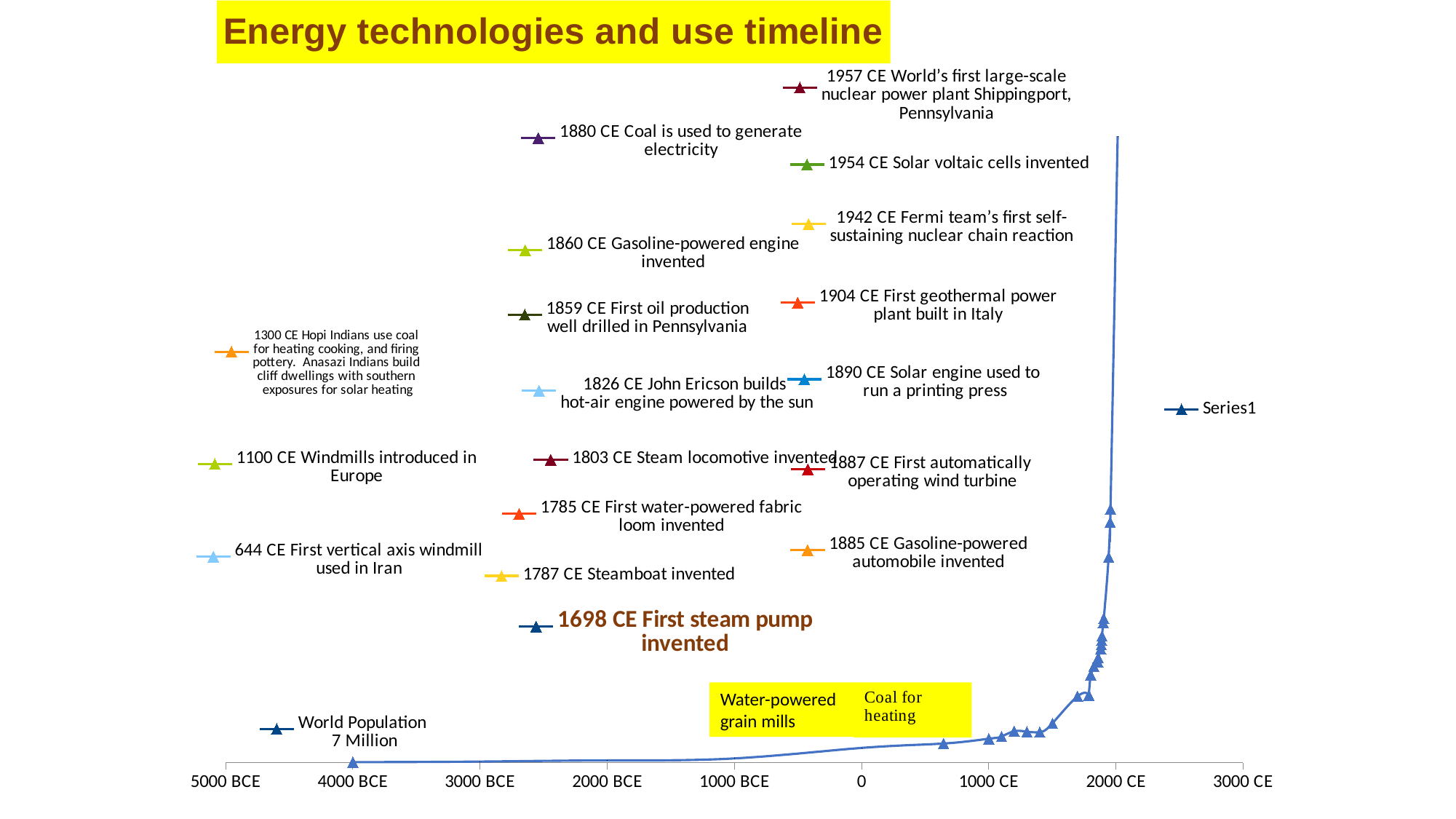
What is the last (rightmost) tick label on the x axis? 3000 CE What is the title of the slide's chart? Energy technologies and use timeline What world population value is annotated at the earliest plotted point? 7 Million How many tick labels are shown on the x axis? 9 Does the plotted line rise or fall as the x axis moves from 5000 BCE toward 2000 CE? rise What kind of chart is shown on the slide? line chart How many series does the chart legend list? 1 What is the name of the series shown in the chart legend? Series1 What is the first (leftmost) tick label on the x axis? 5000 BCE Is the plotted line higher at 2000 CE or at 1000 CE? 2000 CE